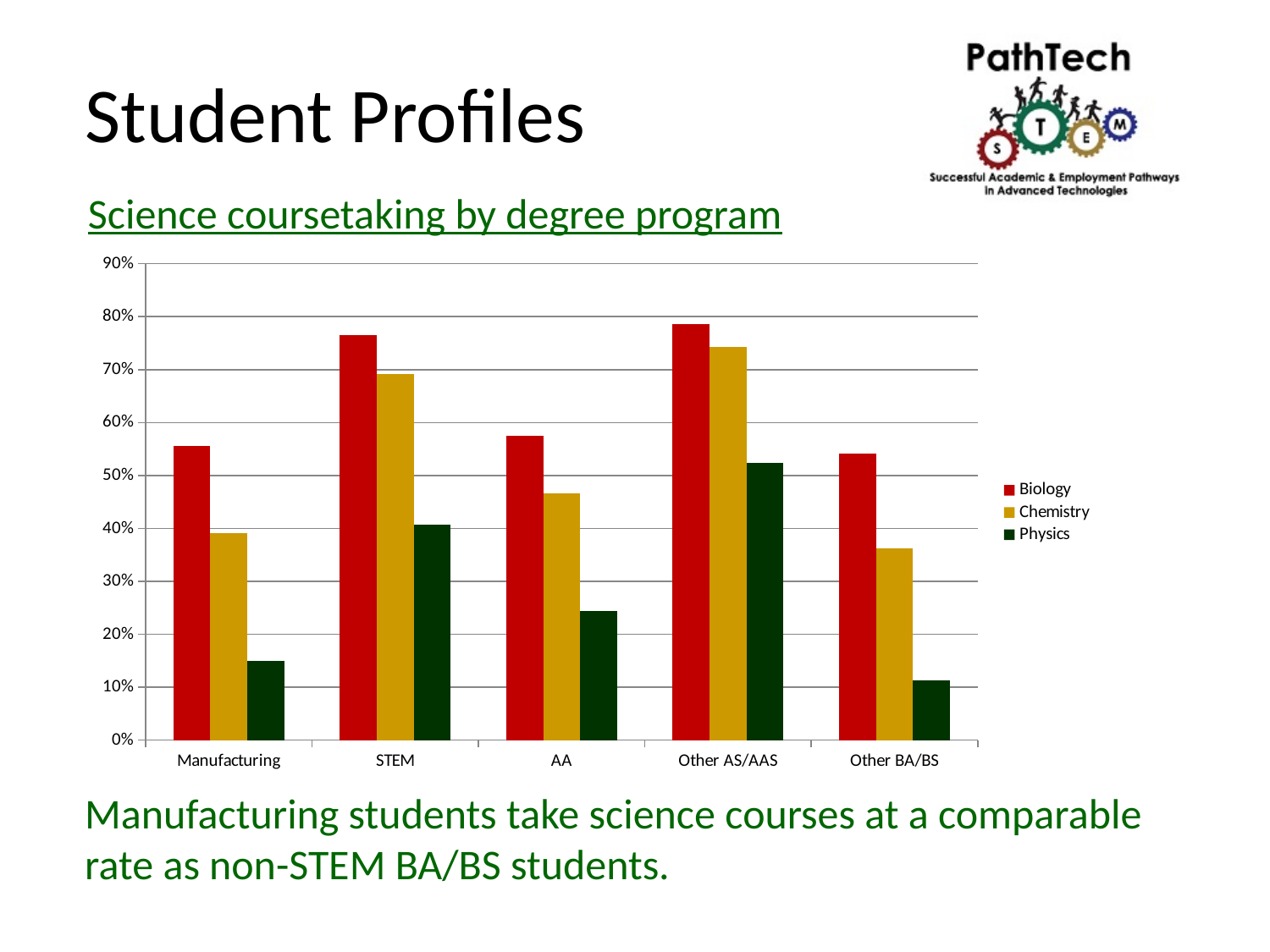
What is the title of the chart? Science coursetaking by degree program Which degree program has the lowest Physics value? Other BA/BS How many series does the legend list? 3 Is the Biology value for STEM greater or less than 70%? greater Which degree program has the highest Chemistry value? Other AS/AAS How many degree program categories are shown on the x axis? 5 Which is larger, the Chemistry value for STEM or the Chemistry value for AA? STEM Which degree program has the highest Physics value? Other AS/AAS Is the Physics value for Other AS/AAS greater or less than 50%? greater What kind of chart is shown on the slide? bar chart Is the Physics value for Manufacturing greater or less than 20%? less